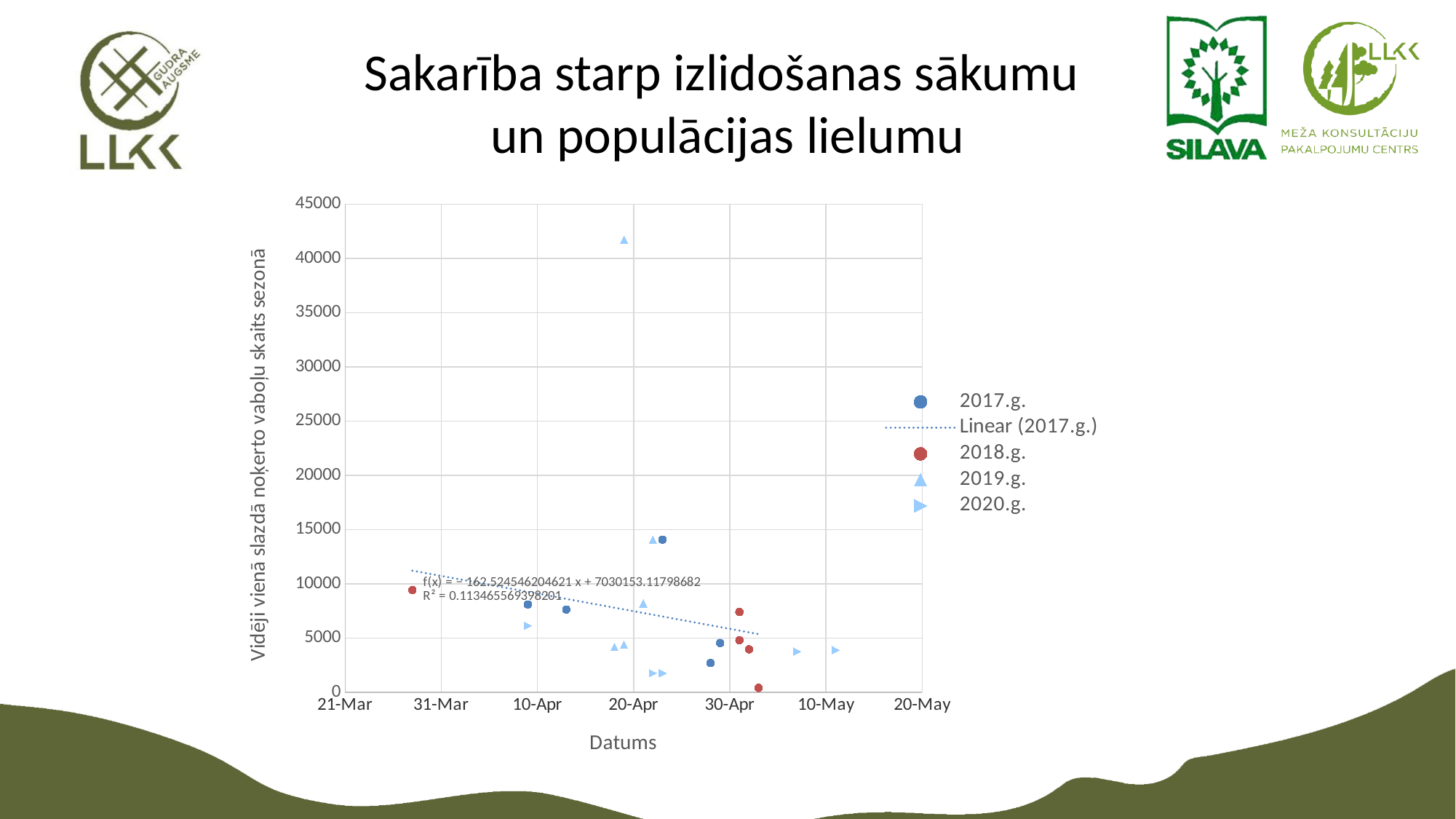
What R² value is printed on the chart for the 2017.g. trendline? 0.113465569398201 Is the highest 2019.g. point on the chart greater or less than 40000? greater Is the highest 2017.g. point on the chart greater or less than 10000? greater How many entries does the chart legend list? 5 Which is larger: the highest 2019.g. point or the highest 2017.g. point? the highest 2019.g. point What is the highest value shown on the y axis of the chart? 45000 Is the lowest 2018.g. point on the chart greater or less than 5000? less Does the Linear (2017.g.) trendline rise or fall from left to right along the x axis? fall What is the title of the x axis of the chart? Datums Which series contains the highest plotted point on the chart? 2019.g. What kind of chart is shown on the slide? scatter chart